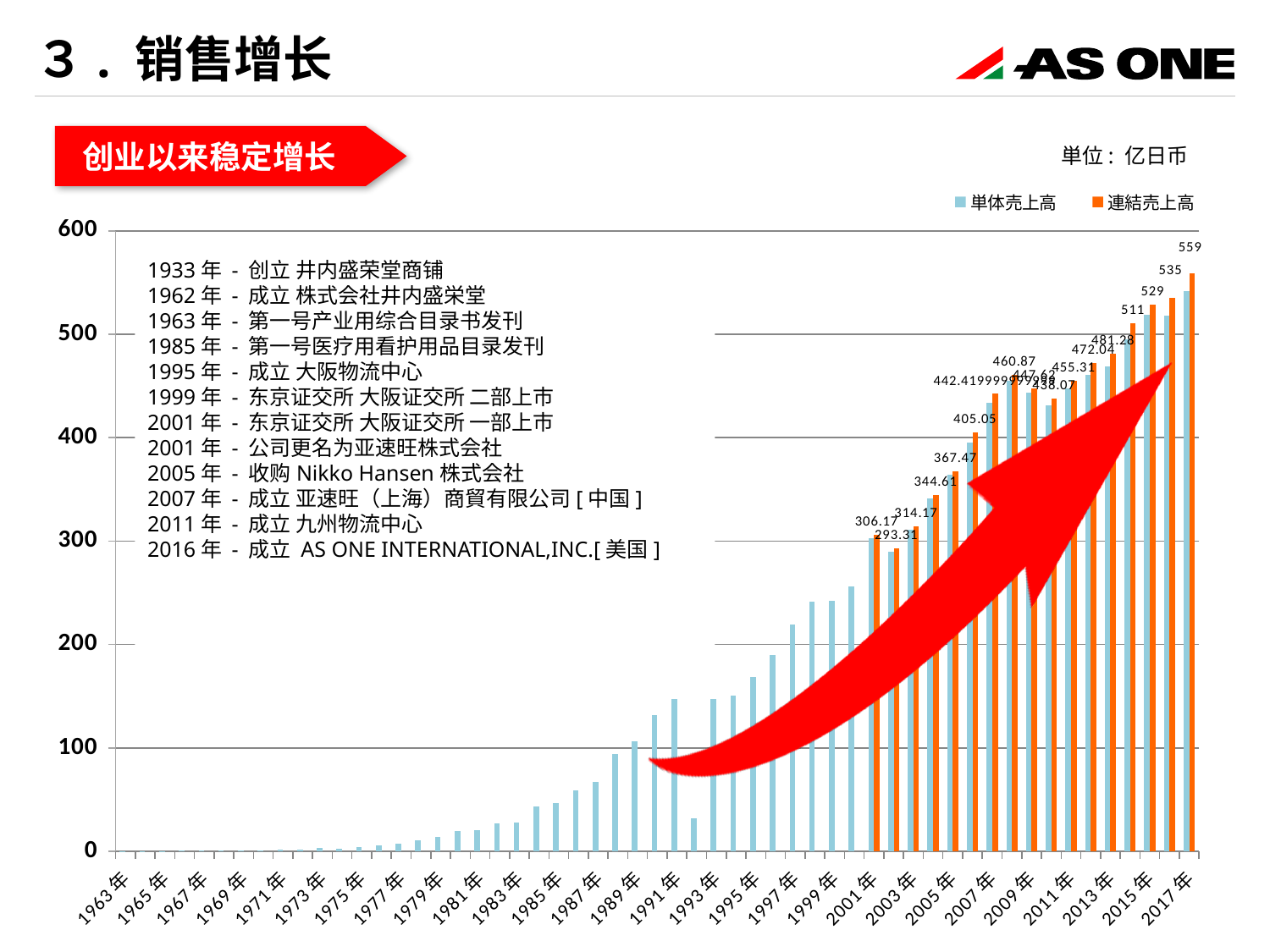
Which year has the highest 連結売上高 value? 2017年 Is the 単体売上高 value for 1999年 greater or less than 200? greater What is the difference between the 連結売上高 values labeled 529 and 511? 18 What is the 連結売上高 value labeled for 2017年? 559 What is the lowest labeled 連結売上高 value on the chart? 293.31 What unit is stated for the chart values? 亿日币 What kind of chart is shown on the slide? bar chart How many series does the chart legend list? 2 Which is larger, the 連結売上高 value labeled 306.17 or the one labeled 293.31? 306.17 What are the two series named in the chart legend? 単体売上高 and 連結売上高 Overall, do the 単体売上高 values rise or fall from 1963年 to 2017年? rise What is the difference between the 連結売上高 values labeled 559 and 535? 24